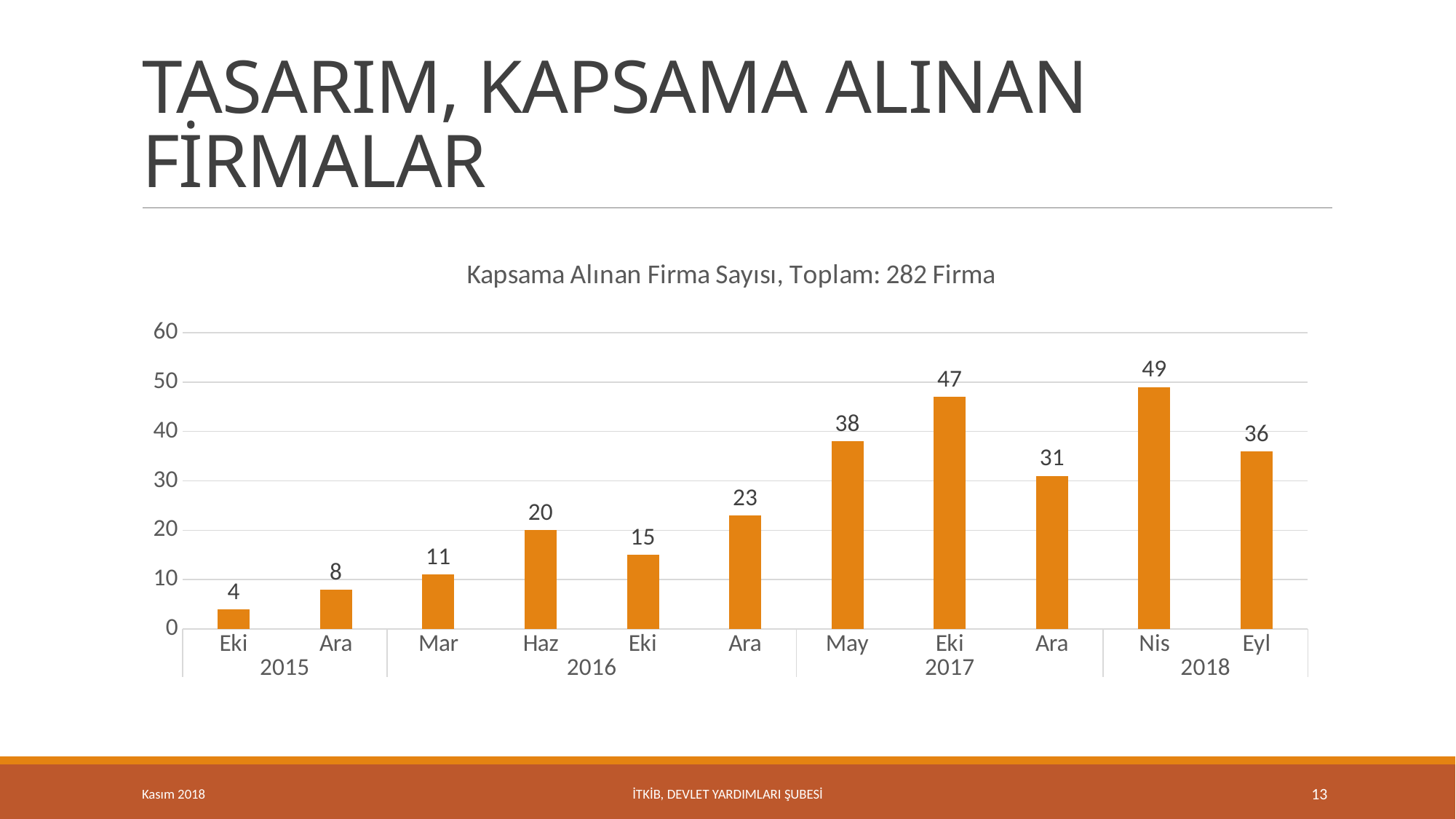
What is the value for Eki 2015? 4 Which is larger, the value for Haz 2016 or the value for Eki 2016? Haz 2016 What is the value for Ara 2017? 31 What kind of chart is shown on the slide? bar chart How many bars are shown in the chart? 11 What is the difference between the values for Ara 2015 and Eki 2015? 4 What is the value for Nis 2018? 49 Is the value for Eyl 2018 greater or less than 30? greater What is the chart's title? Kapsama Alınan Firma Sayısı, Toplam: 282 Firma What is the difference between the values for Eki 2017 and May 2017? 9 Which period has the lowest value? Eki 2015 Which period has the highest value? Nis 2018